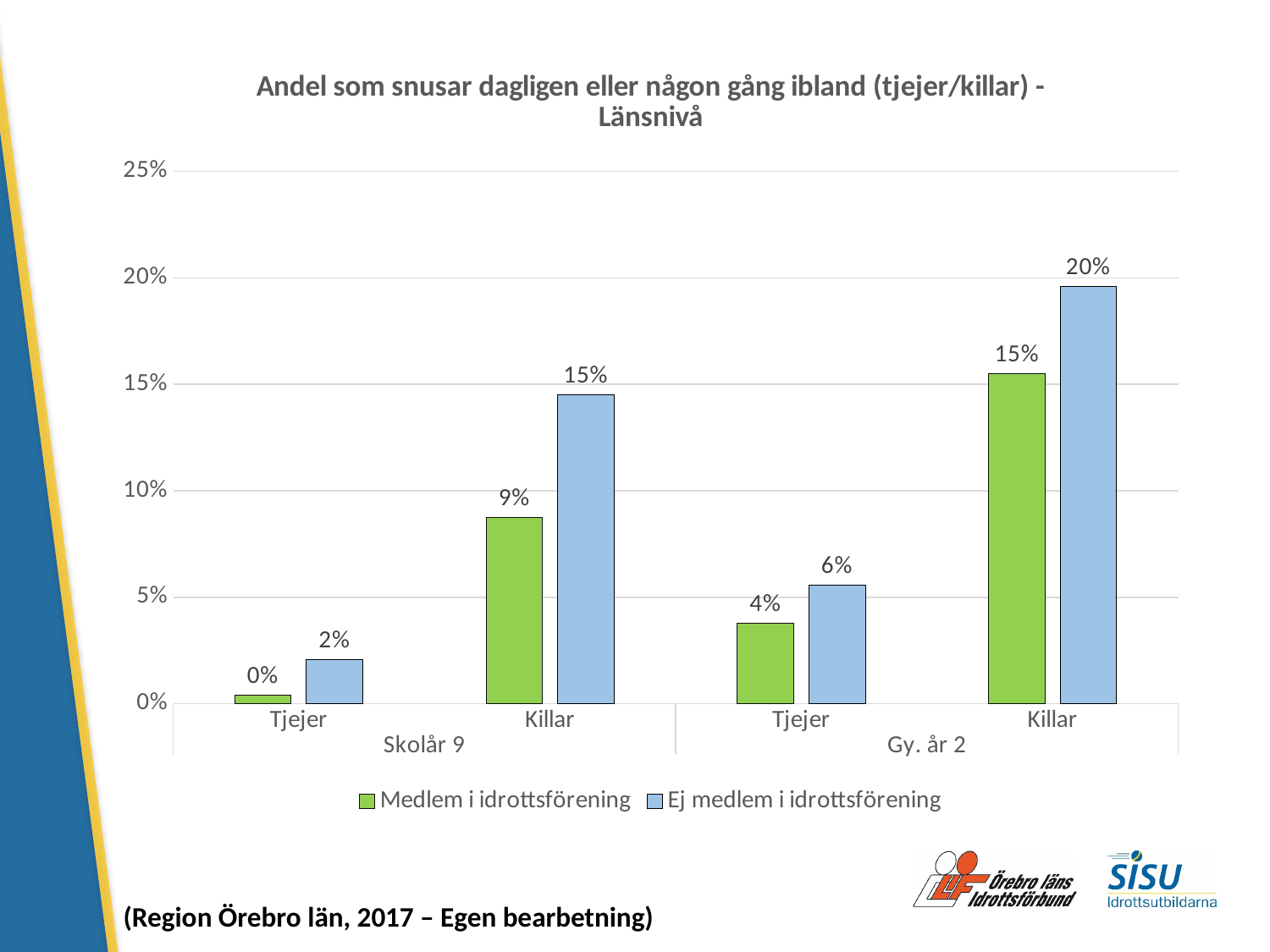
Which category has the highest value for the series Ej medlem i idrottsförening? Killar (Gy. år 2) For Tjejer in Gy. år 2, which series has the larger value: Medlem i idrottsförening or Ej medlem i idrottsförening? Ej medlem i idrottsförening What kind of chart is shown on the slide? Bar chart What is the value for Killar in Gy. år 2 for the series Ej medlem i idrottsförening? 20% Which category has the lowest value for the series Medlem i idrottsförening? Tjejer (Skolår 9) What is the value for Tjejer in Skolår 9 for the series Medlem i idrottsförening? 0% What is the difference between the Ej medlem i idrottsförening and Medlem i idrottsförening values for Killar in Skolår 9? 6% What is the value for Tjejer in Gy. år 2 for the series Medlem i idrottsförening? 4% Is the value for Killar in Gy. år 2 for the series Medlem i idrottsförening greater or less than 10%? greater How many series does the legend list? 2 What colour represents the series Medlem i idrottsförening? Green What is the value for Killar in Skolår 9 for the series Ej medlem i idrottsförening? 15%